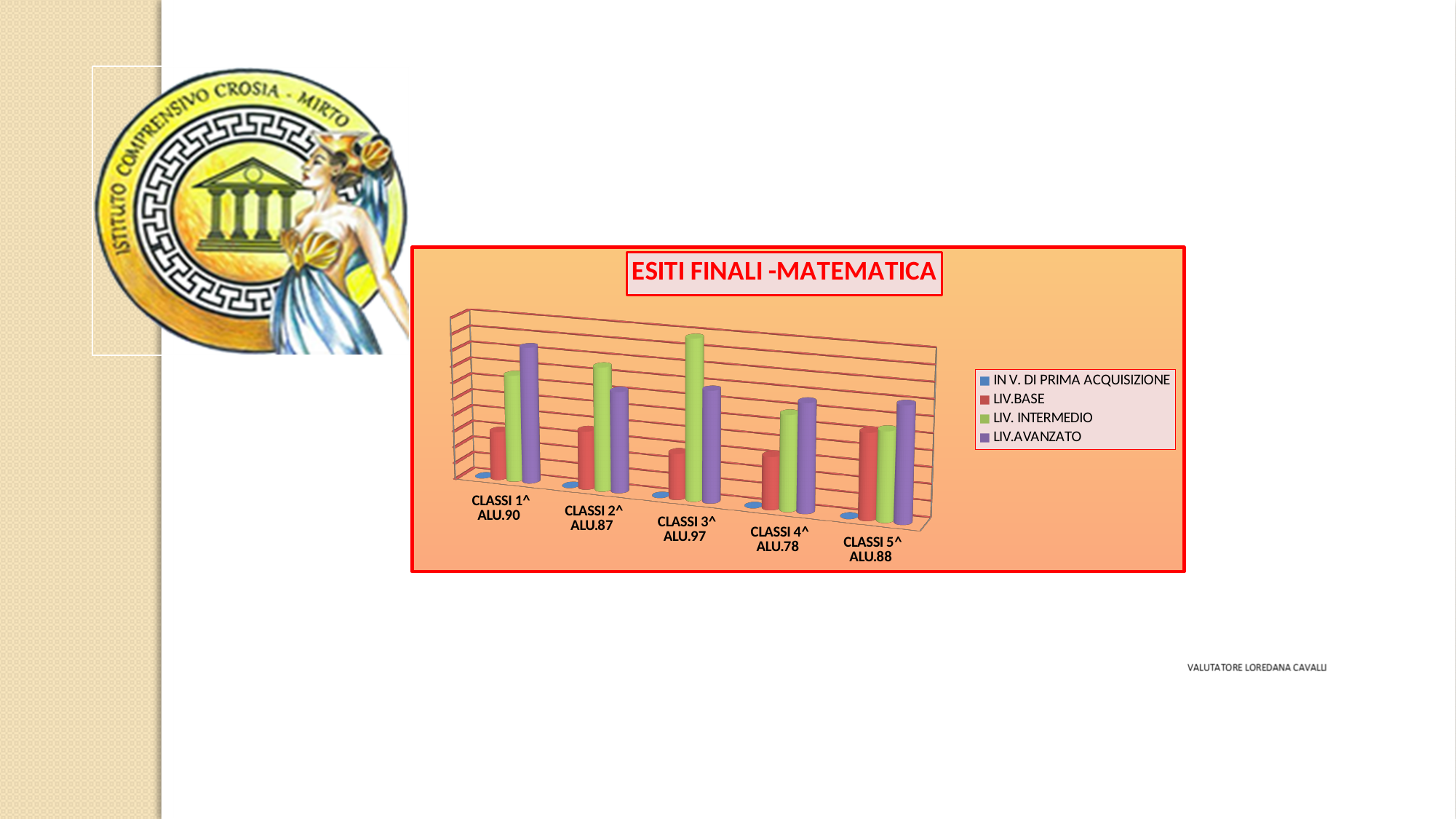
Which class category has the tallest LIV.AVANZATO bar? CLASSI 1^ How many class categories are shown on the x axis of the chart? 5 Which class category has the shortest LIV. INTERMEDIO bar? CLASSI 5^ How many series does the chart legend list? 4 For CLASSI 3^, which is larger: LIV. INTERMEDIO or LIV.AVANZATO? LIV. INTERMEDIO According to the category label, how many alunni (ALU.) are in CLASSI 4^? 78 What kind of chart is shown on the slide? bar chart What is the title of the chart? ESITI FINALI -MATEMATICA Which class category has the tallest LIV.BASE bar? CLASSI 5^ For CLASSI 1^, which is larger: LIV. INTERMEDIO or LIV.AVANZATO? LIV.AVANZATO Which class category has the tallest LIV. INTERMEDIO bar? CLASSI 3^ For CLASSI 2^, which is larger: LIV.BASE or LIV. INTERMEDIO? LIV. INTERMEDIO